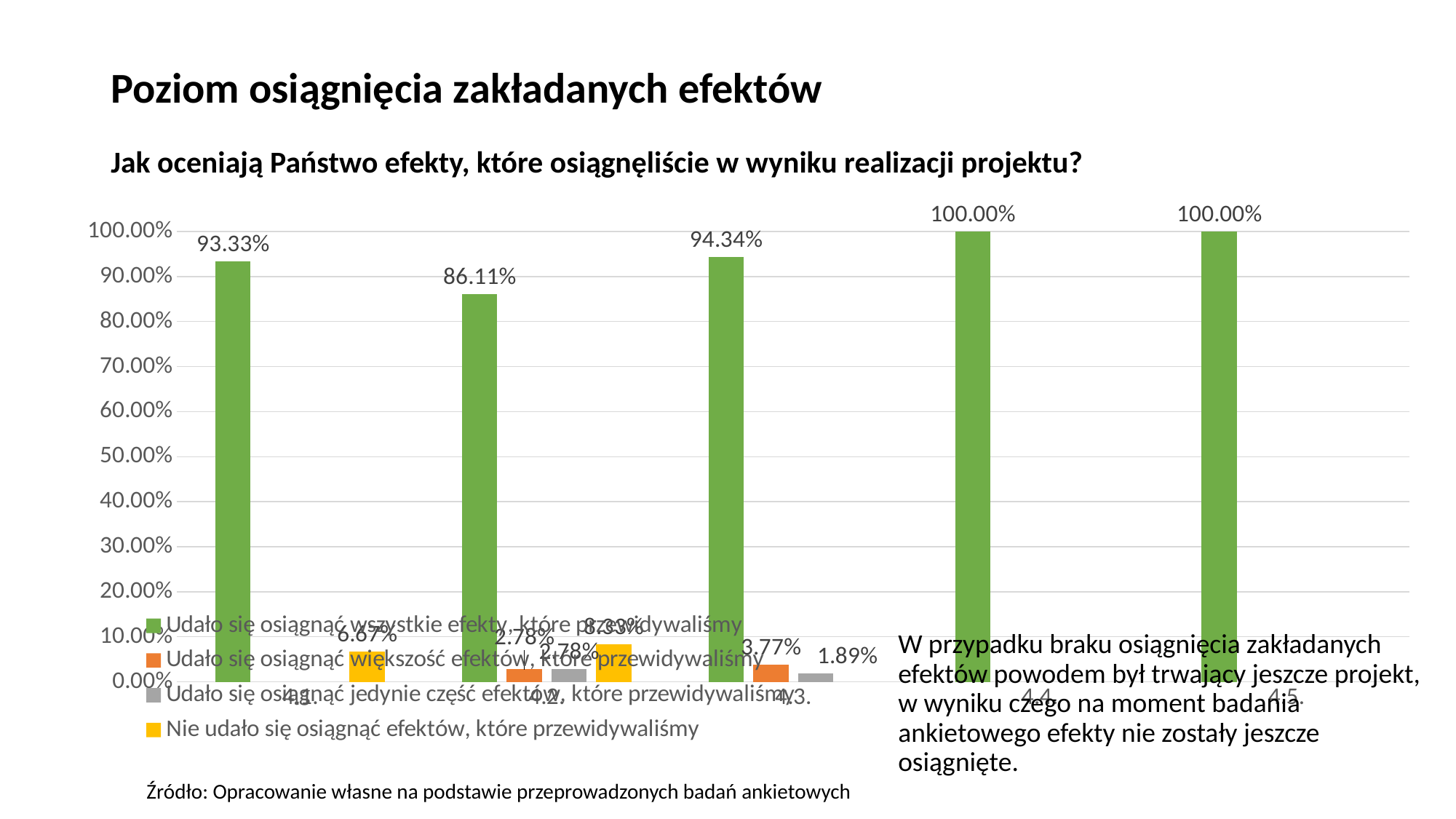
What is the difference between the green series values for categories 4.3. and 4.2.? 8.23% How many series does the legend list? 4 What type of chart is shown on the slide? bar chart What is the value of the yellow series (Nie udało się osiągnąć efektów, które przewidywaliśmy) for category 4.2.? 8.33% What is the value of the green series (Udało się osiągnąć wszystkie efekty, które przewidywaliśmy) for category 4.2.? 86.11% Is the green series value for category 4.2. greater or less than 90.00%? less Which is larger: the green series value for category 4.1. or for category 4.3.? 4.3. What is the question shown as the chart's heading? Jak oceniają Państwo efekty, które osiągnęliście w wyniku realizacji projektu? What is the value of the green series for category 4.3.? 94.34% What is the value of the orange series (Udało się osiągnąć większość efektów, które przewidywaliśmy) for category 4.3.? 3.77% Which category has the lowest value for the green series? 4.2. What is the value of the green series for category 4.4.? 100.00%